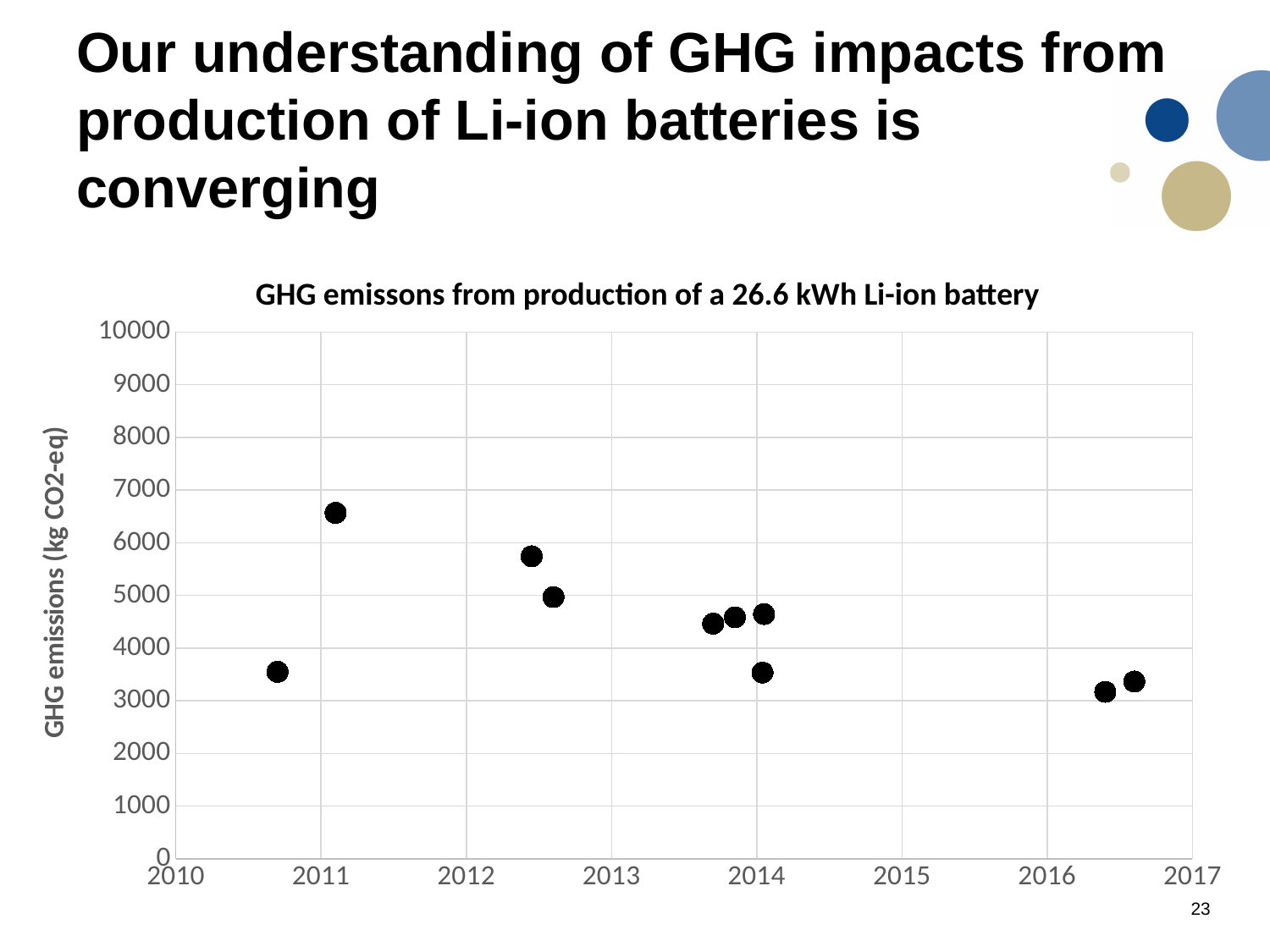
Around which year is the data point with the highest GHG emissions value located? 2011 How many data points are plotted on the chart? 10 What is the maximum value shown on the vertical axis? 10000 Is the value of the highest data point (near 2011) greater or less than 6000? greater What is the title of the chart? GHG emissons from production of a 26.6 kWh Li-ion battery Is the value of the earliest data point (near 2010-2011) greater or less than 3000? greater What is the label of the vertical axis? GHG emissions (kg CO2-eq) Is the value of the higher of the two data points plotted in 2012 greater or less than 5000? greater What kind of chart is shown on the slide? Scatter chart Which has the larger value: the data point near 2011 or the data point near 2016.5? The data point near 2011 Do the GHG emissions values generally rise or fall from 2011 to 2017 along the x axis? fall